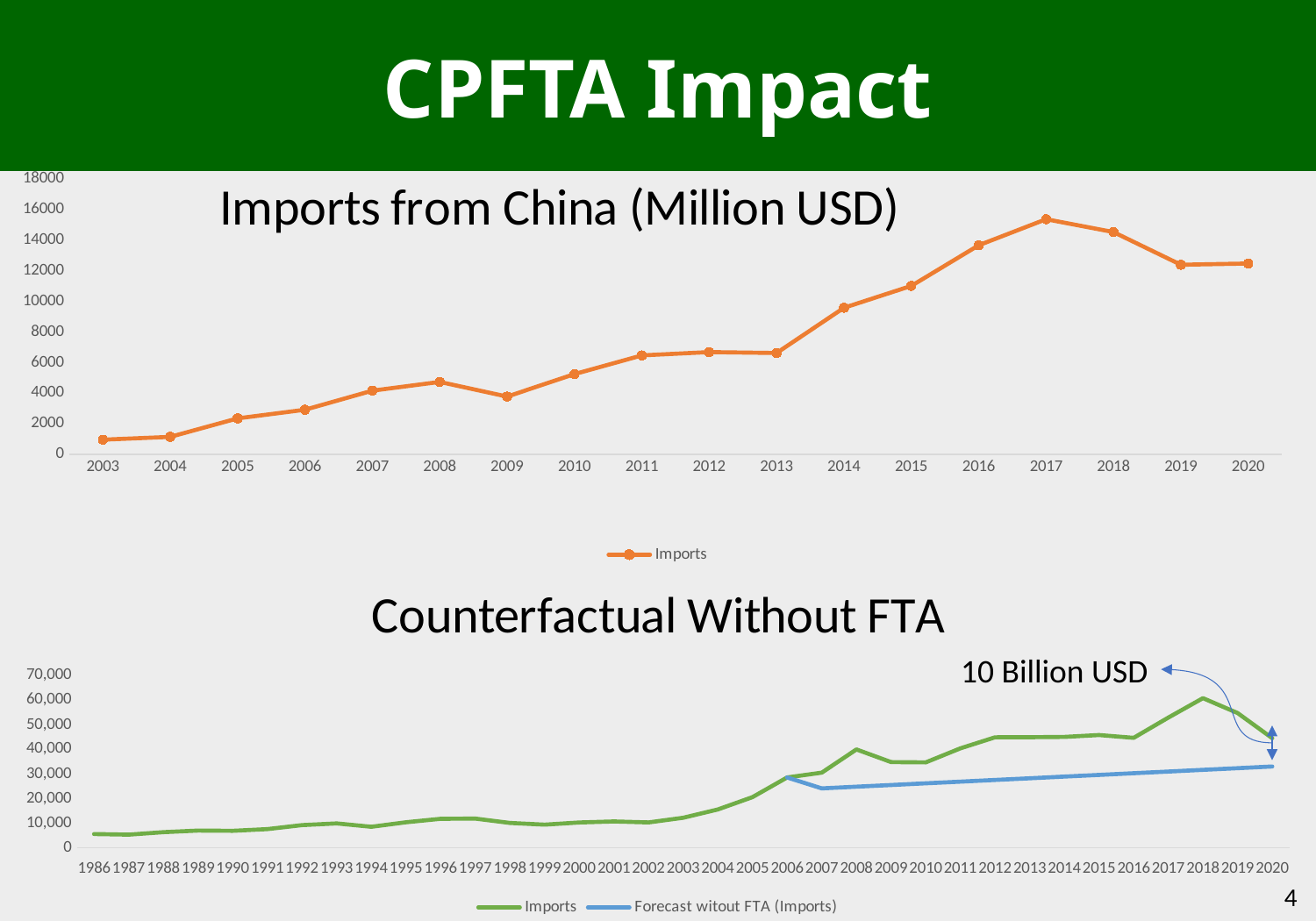
In the top chart 'Imports from China (Million USD)', what kind of chart is shown? line chart In the top chart 'Imports from China (Million USD)', is the value for 2017 greater or less than 14000? greater In the top chart 'Imports from China (Million USD)', which year has the lowest value? 2003 In the bottom chart 'Counterfactual Without FTA', how many series does the legend list? 2 In the bottom chart 'Counterfactual Without FTA', in which year does the Imports series reach its highest value? 2018 In the bottom chart 'Counterfactual Without FTA', is the Imports value for 2018 greater or less than 50,000? greater In the top chart 'Imports from China (Million USD)', how many years are plotted on the x axis? 18 In the top chart 'Imports from China (Million USD)', which year has the larger value, 2014 or 2009? 2014 In the bottom chart 'Counterfactual Without FTA', what are the two legend entries? Imports; Forecast witout FTA (Imports) In the top chart 'Imports from China (Million USD)', which year has the highest value? 2017 In the top chart 'Imports from China (Million USD)', do the values generally rise or fall from 2003 to 2017? rise